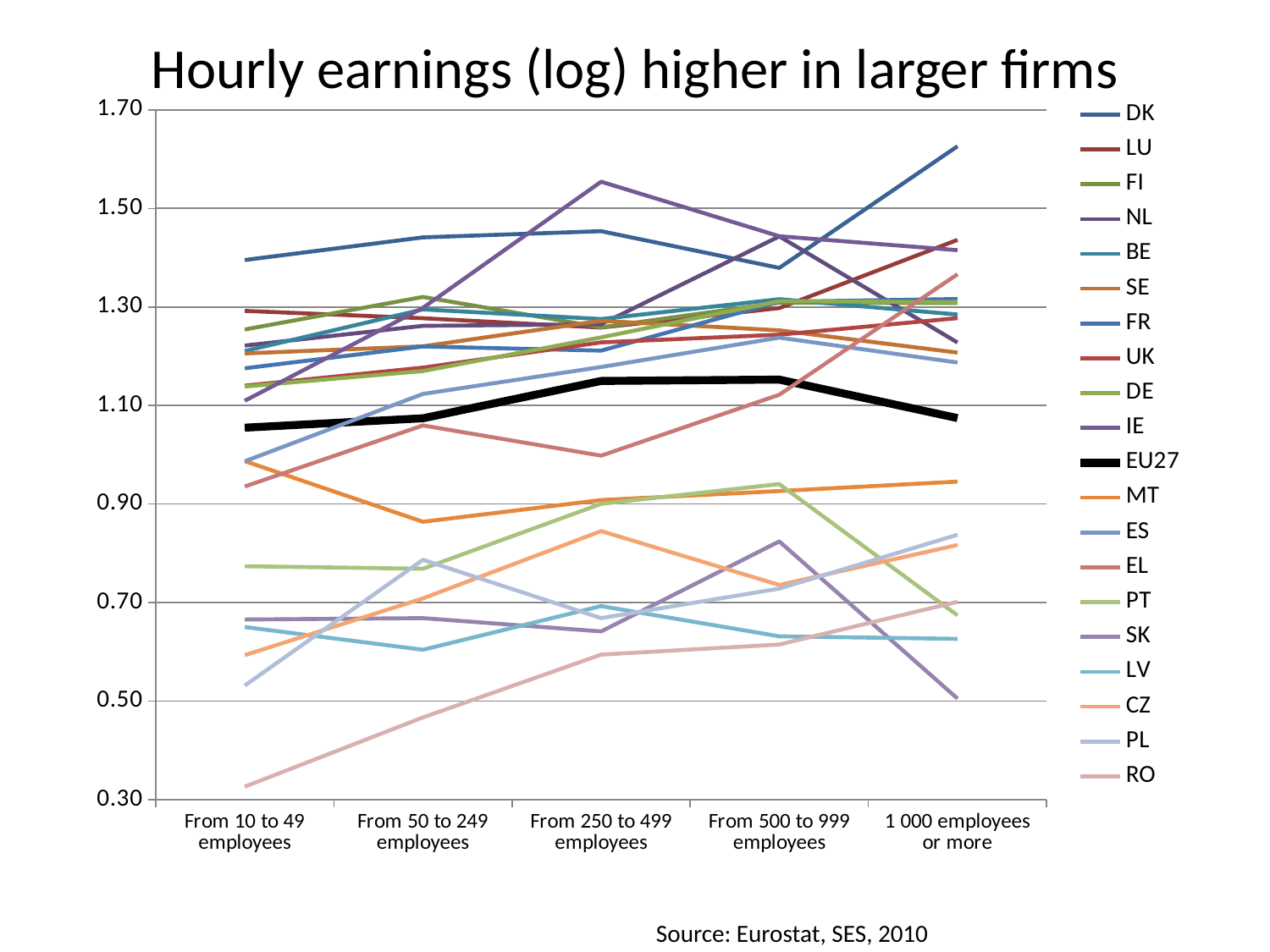
How many series does the legend list? 20 Is the value for RO at 'From 10 to 49 employees' greater or less than 0.50? less What kind of chart is shown on the slide? Line chart What is the title of the chart? Hourly earnings (log) higher in larger firms Is the value for EU27 at 'From 10 to 49 employees' greater or less than 1.10? less Which series has the highest value for 'From 250 to 499 employees'? IE Which series has the highest value for '1 000 employees or more'? DK Does the RO line rise or fall as firm size increases along the x axis? rise Which series is drawn with the thick black line? EU27 How many firm-size categories are shown on the x axis? 5 Is the value for DK at '1 000 employees or more' greater or less than 1.50? greater Which series has the lowest value for 'From 10 to 49 employees'? RO